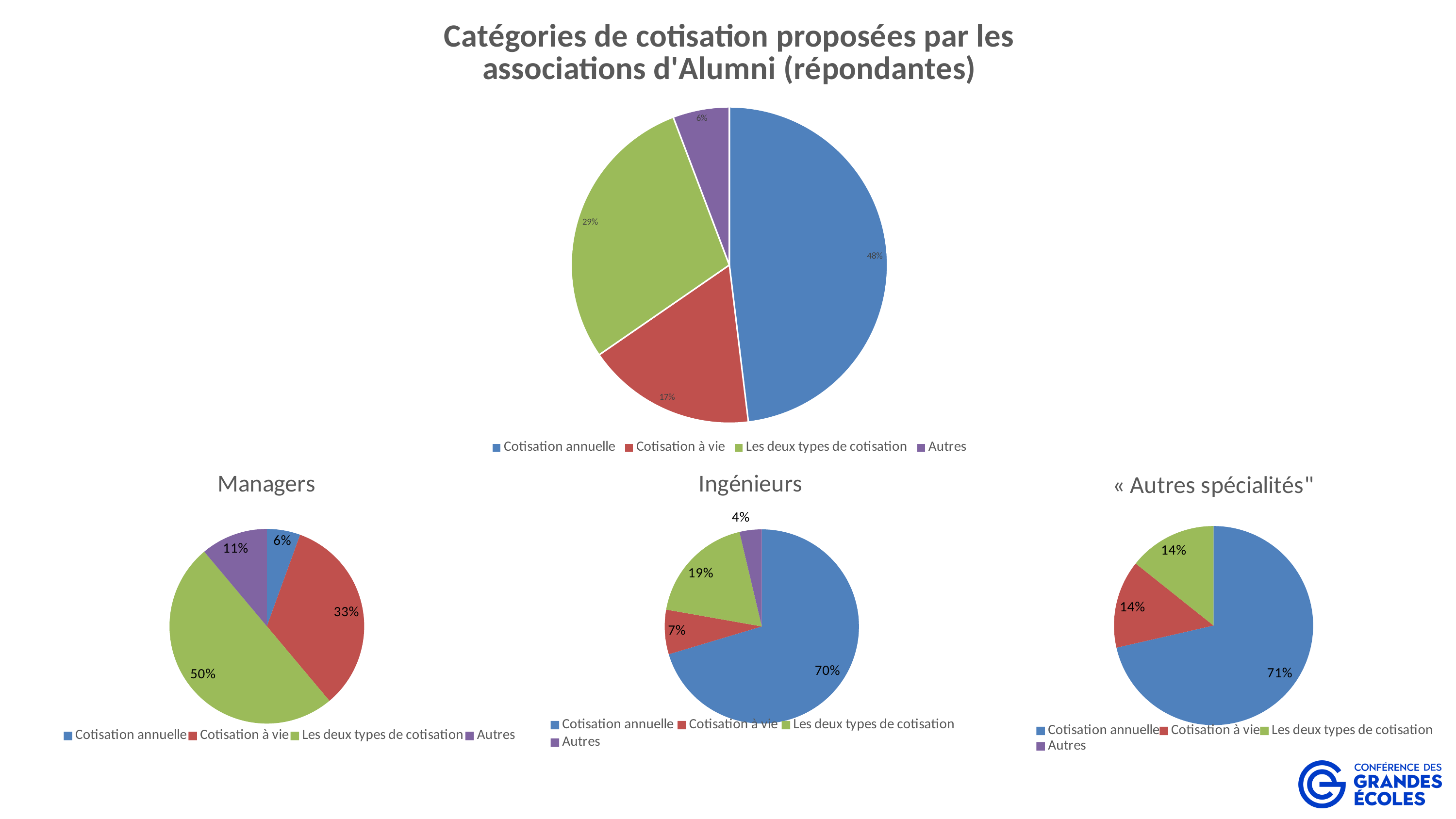
In the top chart 'Catégories de cotisation proposées par les associations d'Alumni (répondantes)', what share is 'Cotisation annuelle'? 48% In the 'Managers' chart, what share is 'Les deux types de cotisation'? 50% In the top chart 'Catégories de cotisation proposées par les associations d'Alumni (répondantes)', what is the difference between 'Cotisation annuelle' and 'Cotisation à vie'? 31% In the top chart 'Catégories de cotisation proposées par les associations d'Alumni (répondantes)', what share is 'Les deux types de cotisation'? 29% What type of chart is the 'Ingénieurs' chart? Pie chart In the 'Ingénieurs' chart, what share is 'Cotisation annuelle'? 70% In the top chart 'Catégories de cotisation proposées par les associations d'Alumni (répondantes)', which category has the smallest slice? Autres How many entries does the legend of the 'Managers' chart list? 4 In the 'Managers' chart, which category has the largest slice? Les deux types de cotisation In the '« Autres spécialités"' chart, what share is 'Cotisation annuelle'? 71% In the 'Ingénieurs' chart, which is larger, 'Cotisation à vie' or 'Les deux types de cotisation'? Les deux types de cotisation In the 'Managers' chart, what share is 'Cotisation à vie'? 33%